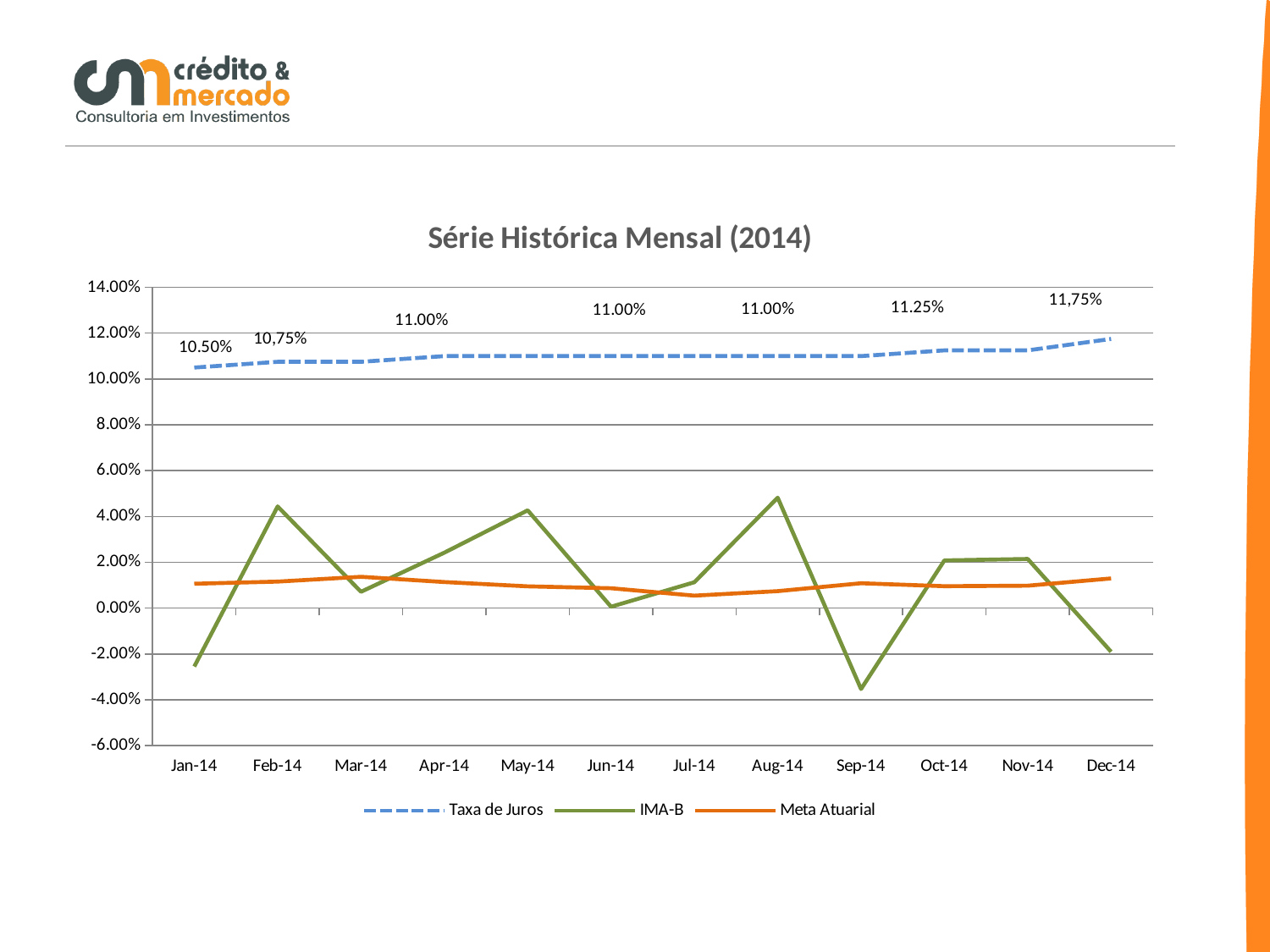
By how much did Taxa de Juros increase from Jan-14 to Dec-14? 1.25 percentage points What is the title of the chart? Série Histórica Mensal (2014) Is the value of IMA-B in Sep-14 greater or less than -2.00%? less What kind of chart is shown on the slide? Line chart Does Taxa de Juros rise or fall over the course of 2014? Rises What is the value of Taxa de Juros in Feb-14? 10,75% What is the value of Taxa de Juros in Dec-14? 11,75% What is the value of Taxa de Juros in Jan-14? 10.50% In which month is Taxa de Juros highest? Dec-14 How many series does the legend list? 3 In which month is IMA-B lowest? Sep-14 How many months are plotted along the x axis? 12